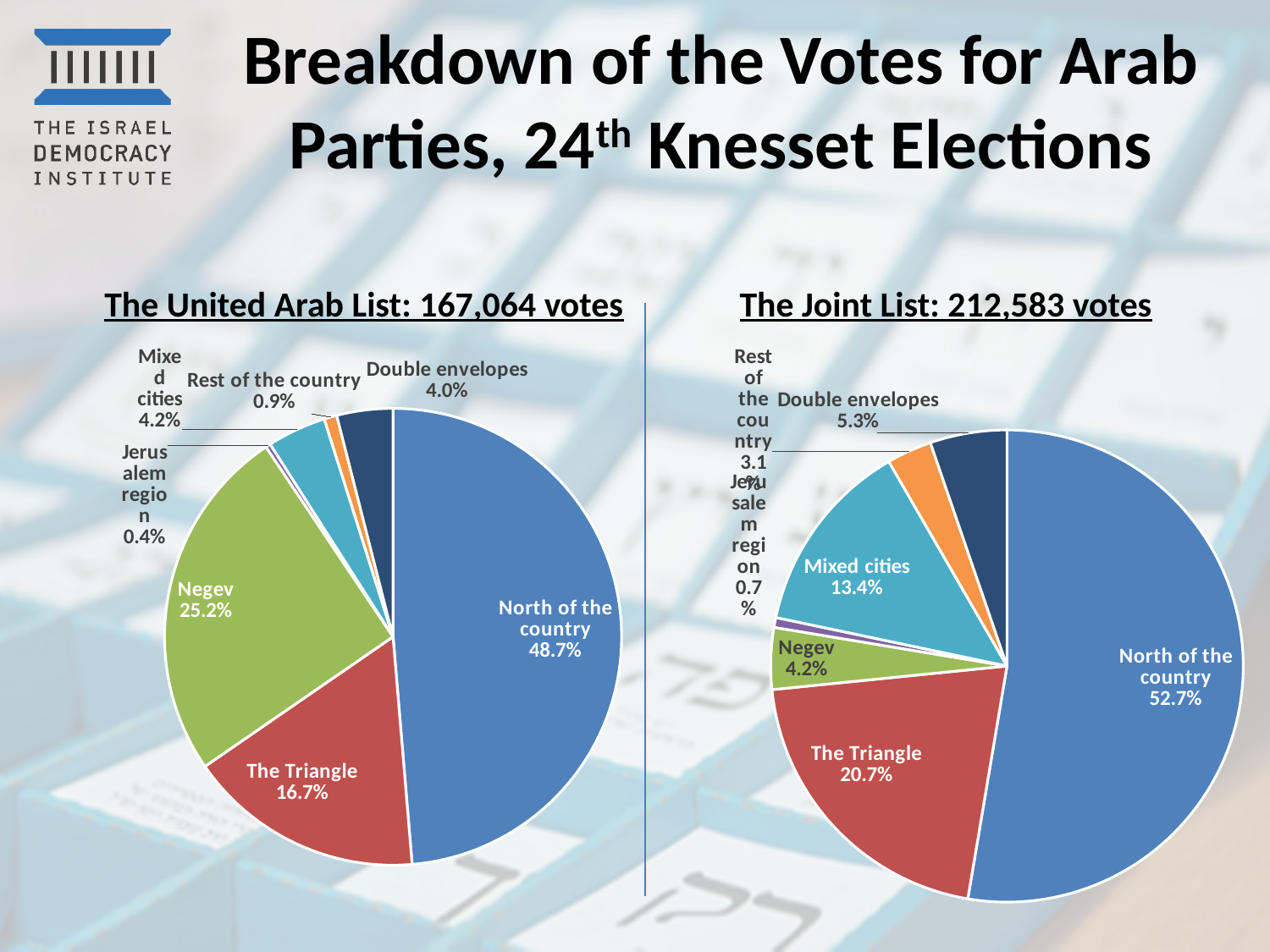
How many slices does the Joint List pie chart have? 7 In the Joint List chart, what share of the votes came from Mixed cities? 13.4% In the Joint List chart, what share of the votes came from The Triangle? 20.7% How many votes did the United Arab List receive according to the chart title? 167,064 votes In the United Arab List chart, what share of the votes came from the Negev? 25.2% In the Joint List chart, what is the difference between the share for the North of the country and the share for The Triangle? 32.0% What kind of charts are shown on the slide? Pie charts In the Joint List chart, which category has the smallest share of votes? Jerusalem region In the Joint List chart, what share of the votes came from Double envelopes? 5.3% In the United Arab List chart, which is larger: the share for the Negev or the share for The Triangle? Negev In the United Arab List chart, what share of the votes came from the North of the country? 48.7% In the United Arab List chart, which region has the largest share of votes? North of the country